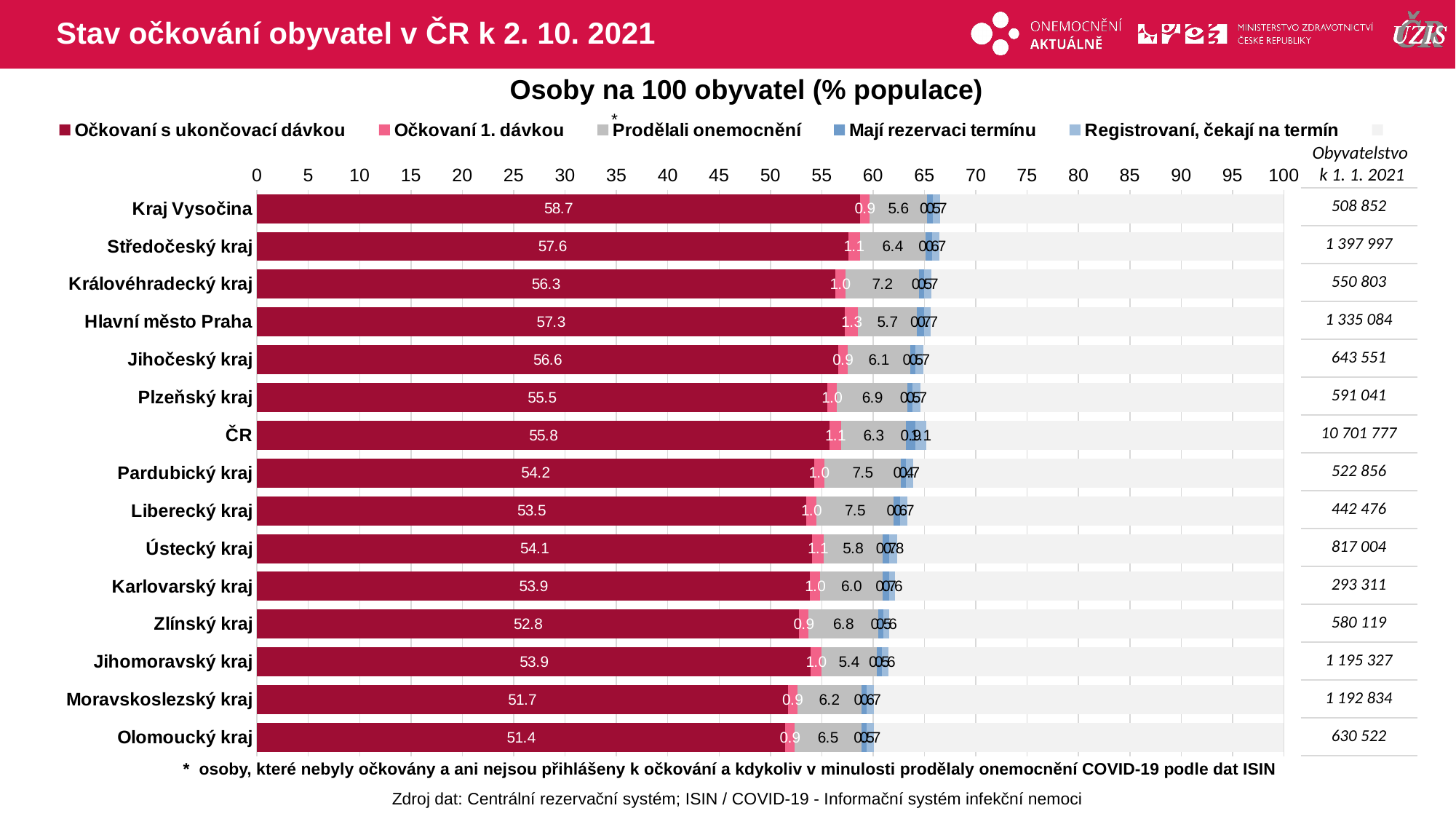
What is the value of Očkovaní s ukončovací dávkou for Olomoucký kraj? 51.4 How many categories (rows) are shown in the chart? 15 Is the value of Očkovaní s ukončovací dávkou for ČR greater or less than 50? greater What is the title of the chart? Osoby na 100 obyvatel (% populace) What is the value of Očkovaní 1. dávkou for Hlavní město Praha? 1.3 Which has a higher value of Očkovaní s ukončovací dávkou, Jihočeský kraj or Plzeňský kraj? Jihočeský kraj Which category has the highest value of Očkovaní s ukončovací dávkou? Kraj Vysočina What is the value of Prodělali onemocnění for Pardubický kraj? 7.5 Which category has the lowest value of Očkovaní s ukončovací dávkou? Olomoucký kraj What is the difference in Očkovaní s ukončovací dávkou between Kraj Vysočina and Olomoucký kraj? 7.3 What kind of chart is shown on the slide? Stacked bar chart What is the value of Očkovaní s ukončovací dávkou for Kraj Vysočina? 58.7